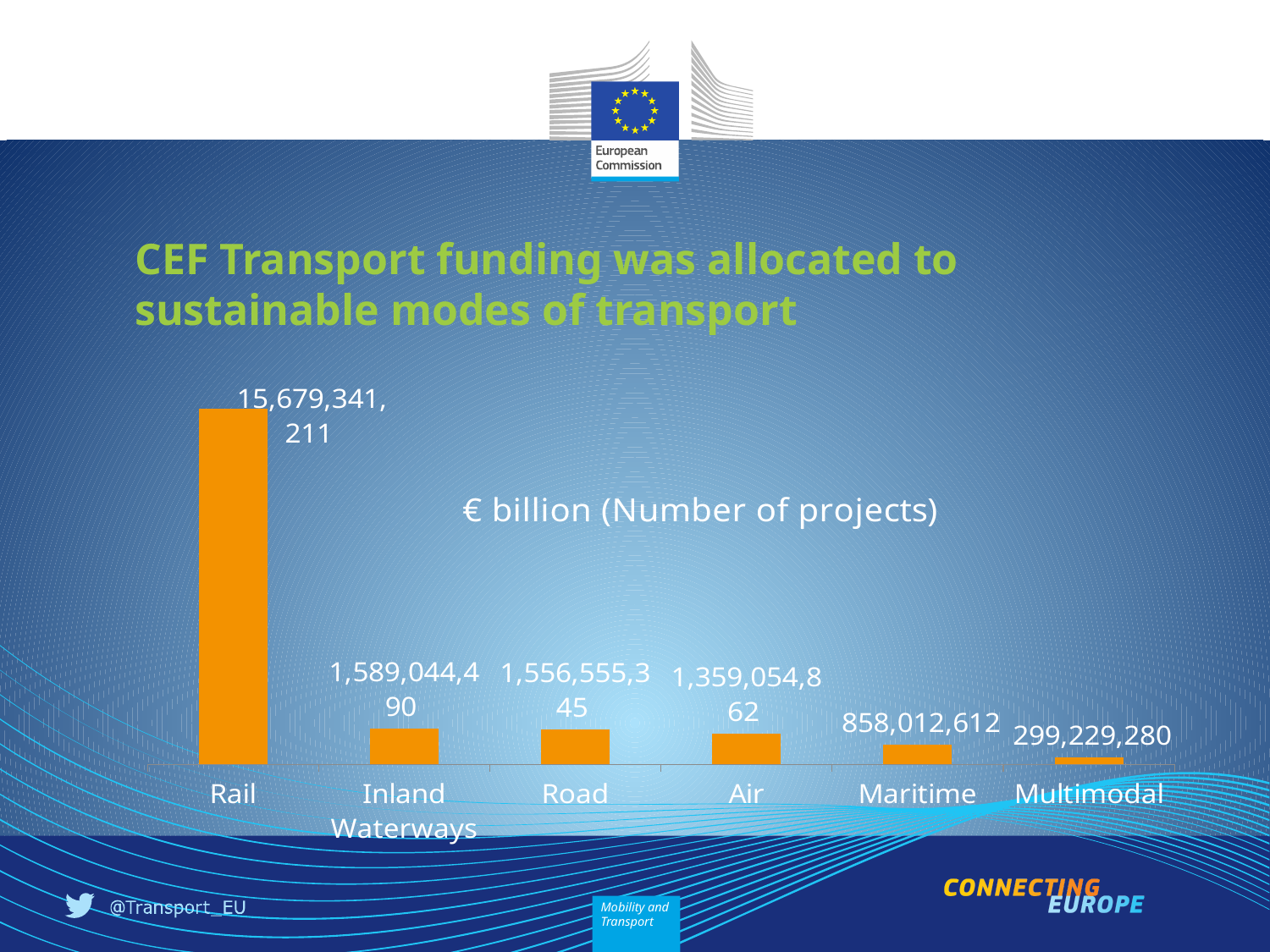
What is the value shown for Multimodal? 299,229,280 Do the values rise or fall from left to right across the categories? Fall What is the value shown for Rail? 15,679,341,211 What is the value shown for Air? 1,359,054,862 What is the difference between the values for Road and Air? 197,500,483 What kind of chart is shown on the slide? Bar chart What is the difference between the values for Maritime and Multimodal? 558,783,332 Which category has the lowest value? Multimodal How many categories are shown on the x axis? 6 Which category has the highest value? Rail What is the value shown for Maritime? 858,012,612 Which is larger, the value for Rail or the value for Air? Rail